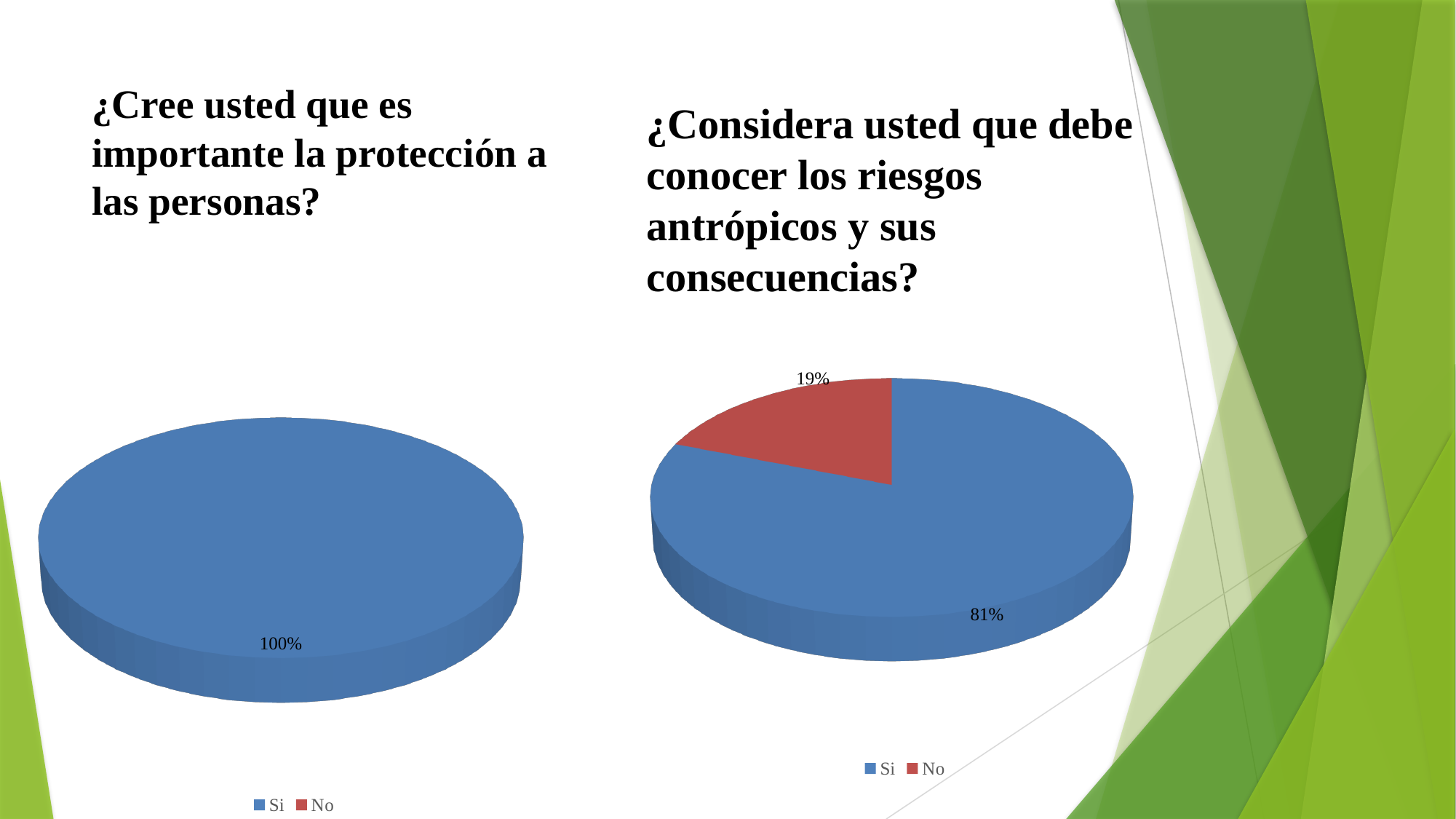
What type of chart is the left chart (¿Cree usted que es importante la protección a las personas?)? Pie chart How many entries does the legend of the left chart (¿Cree usted que es importante la protección a las personas?) list? 2 In the right chart (¿Considera usted que debe conocer los riesgos antrópicos y sus consecuencias?), which slice is the smallest? No In the right chart (¿Considera usted que debe conocer los riesgos antrópicos y sus consecuencias?), what colour is the No slice? Red In the right chart (¿Considera usted que debe conocer los riesgos antrópicos y sus consecuencias?), which is larger, Si or No? Si In the left chart (¿Cree usted que es importante la protección a las personas?), what share of the pie is labelled for Si? 100% In the right chart (¿Considera usted que debe conocer los riesgos antrópicos y sus consecuencias?), what is the difference between the Si and No shares? 62% What is the title of the left chart? ¿Cree usted que es importante la protección a las personas? In the right chart (¿Considera usted que debe conocer los riesgos antrópicos y sus consecuencias?), what share of the pie is Si? 81% In the right chart (¿Considera usted que debe conocer los riesgos antrópicos y sus consecuencias?), which slice is the largest? Si How many entries does the legend of the right chart (¿Considera usted que debe conocer los riesgos antrópicos y sus consecuencias?) list? 2 In the right chart (¿Considera usted que debe conocer los riesgos antrópicos y sus consecuencias?), what share of the pie is No? 19%